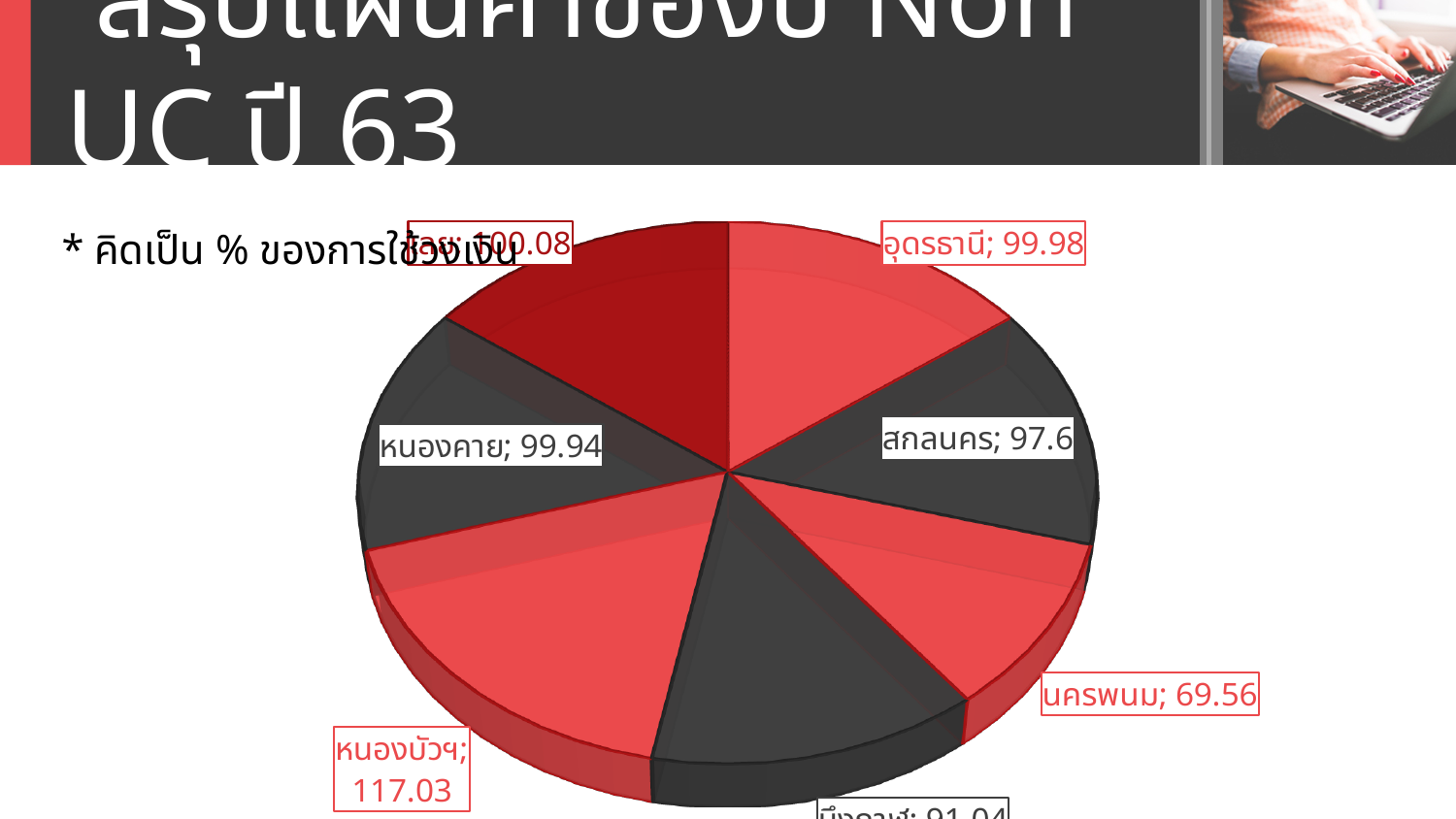
What is the difference between the values for หนองบัวฯ and นครพนม? 47.47 Which category has the highest value in the pie chart? หนองบัวฯ Which category has the lowest value in the pie chart? นครพนม What is the value shown for สกลนคร? 97.6 Which has a larger value, สกลนคร or นครพนม? สกลนคร What type of chart is shown on the slide? pie chart What is the value shown for หนองบัวฯ? 117.03 What is the difference between the values for อุดรธานี and สกลนคร? 2.38 What is the value shown for หนองคาย? 99.94 What is the value shown for นครพนม? 69.56 How many slices does the pie chart have? 7 What is the value shown for อุดรธานี? 99.98